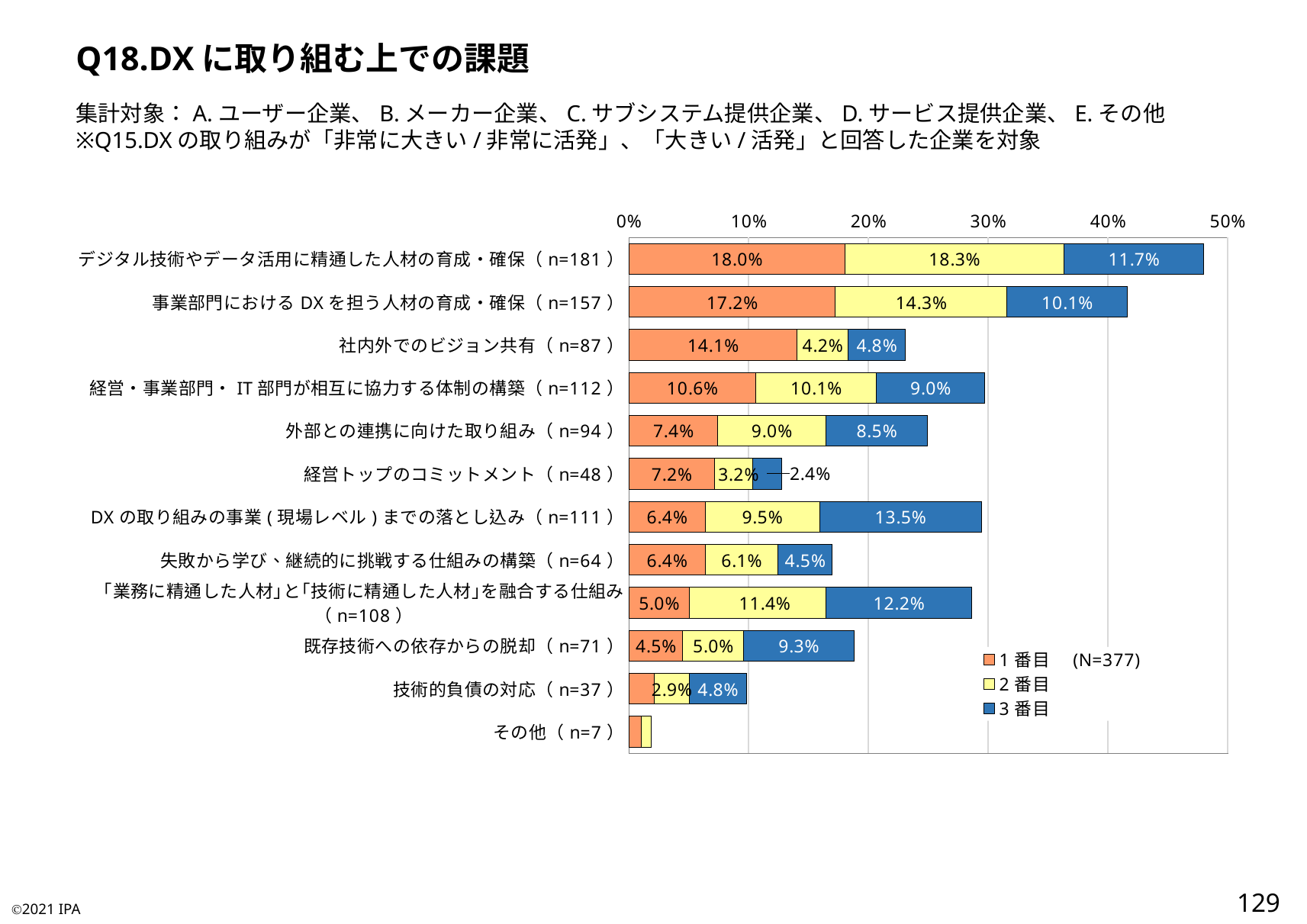
How many categories are plotted on the chart? 12 Is the total length of the bar for 経営・事業部門・IT部門が相互に協力する体制の構築 greater or less than 20%? greater What kind of chart is shown on the slide? stacked bar chart Which is larger: the 3番目 value for 既存技術への依存からの脱却 or the 3番目 value for 外部との連携に向けた取り組み? 既存技術への依存からの脱却 Which category has the highest 1番目 value? デジタル技術やデータ活用に精通した人材の育成・確保 How many series does the legend list? 3 What is the 3番目 value for DXの取り組みの事業(現場レベル)までの落とし込み? 13.5% What N value is shown next to the legend? N=377 What is the total of the stacked bar for 事業部門におけるDXを担う人材の育成・確保? 41.6% What is the 2番目 value for 「業務に精通した人材」と「技術に精通した人材」を融合する仕組み? 11.4% What is the difference between the 1番目 values for 社内外でのビジョン共有 and 経営トップのコミットメント? 6.9% What is the 1番目 value for デジタル技術やデータ活用に精通した人材の育成・確保? 18.0%